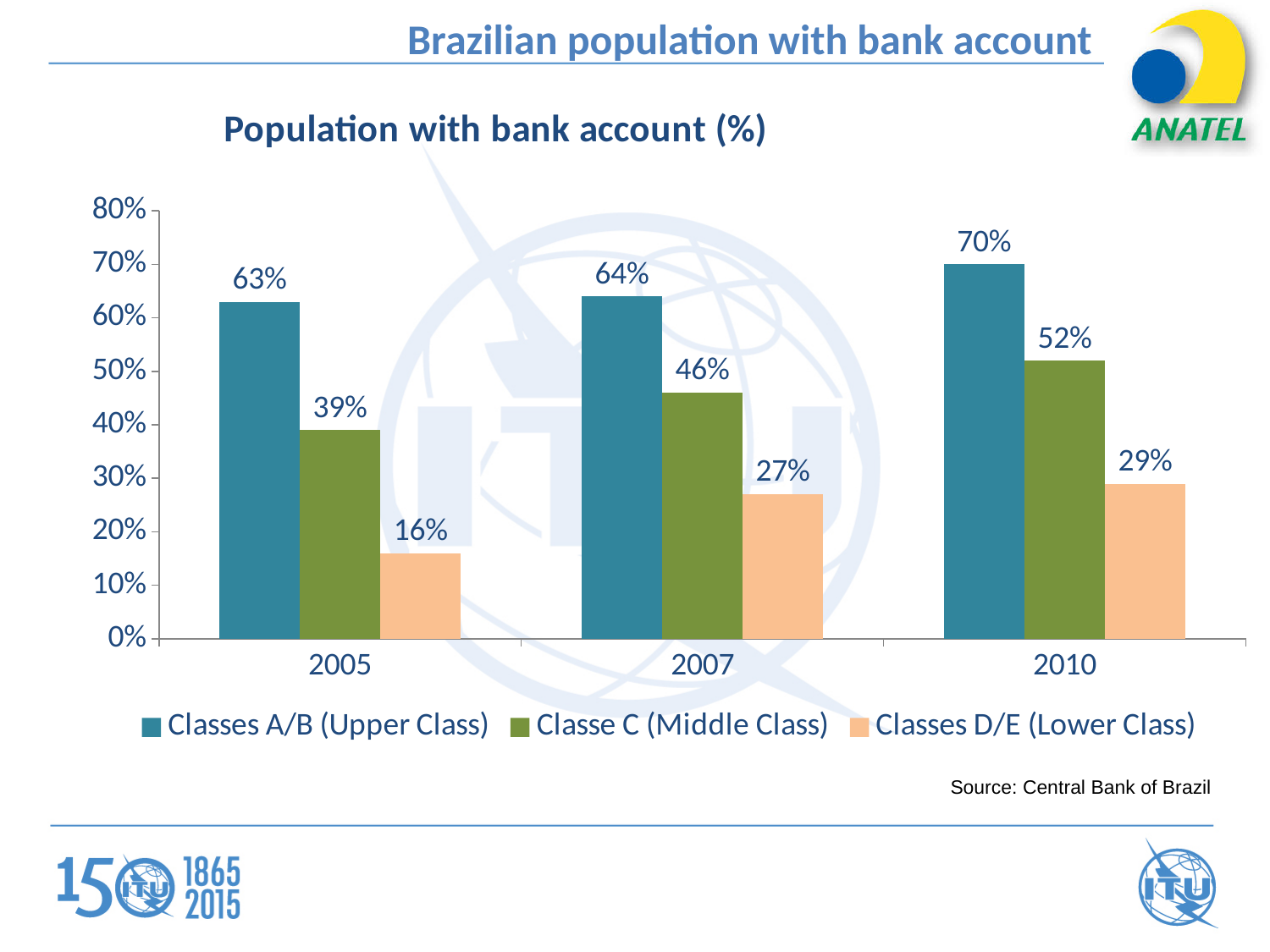
Do the values for Classe C (Middle Class) rise or fall from 2005 to 2010? rise What percentage of Classes A/B (Upper Class) had a bank account in 2005? 63% What is the difference between the Classes A/B (Upper Class) and Classes D/E (Lower Class) values in 2010? 41% How many series does the legend list? 3 Which is larger: Classe C (Middle Class) in 2010 or Classes A/B (Upper Class) in 2005? Classes A/B (Upper Class) in 2005 How many years are shown on the x axis? 3 What is the value for Classes D/E (Lower Class) in 2010? 29% In which year is the value for Classes A/B (Upper Class) highest? 2010 What kind of chart is shown on the slide? bar chart Is the value for Classe C (Middle Class) in 2005 greater or less than 40%? less What is the value for Classe C (Middle Class) in 2007? 46% In which year is the value for Classes D/E (Lower Class) lowest? 2005